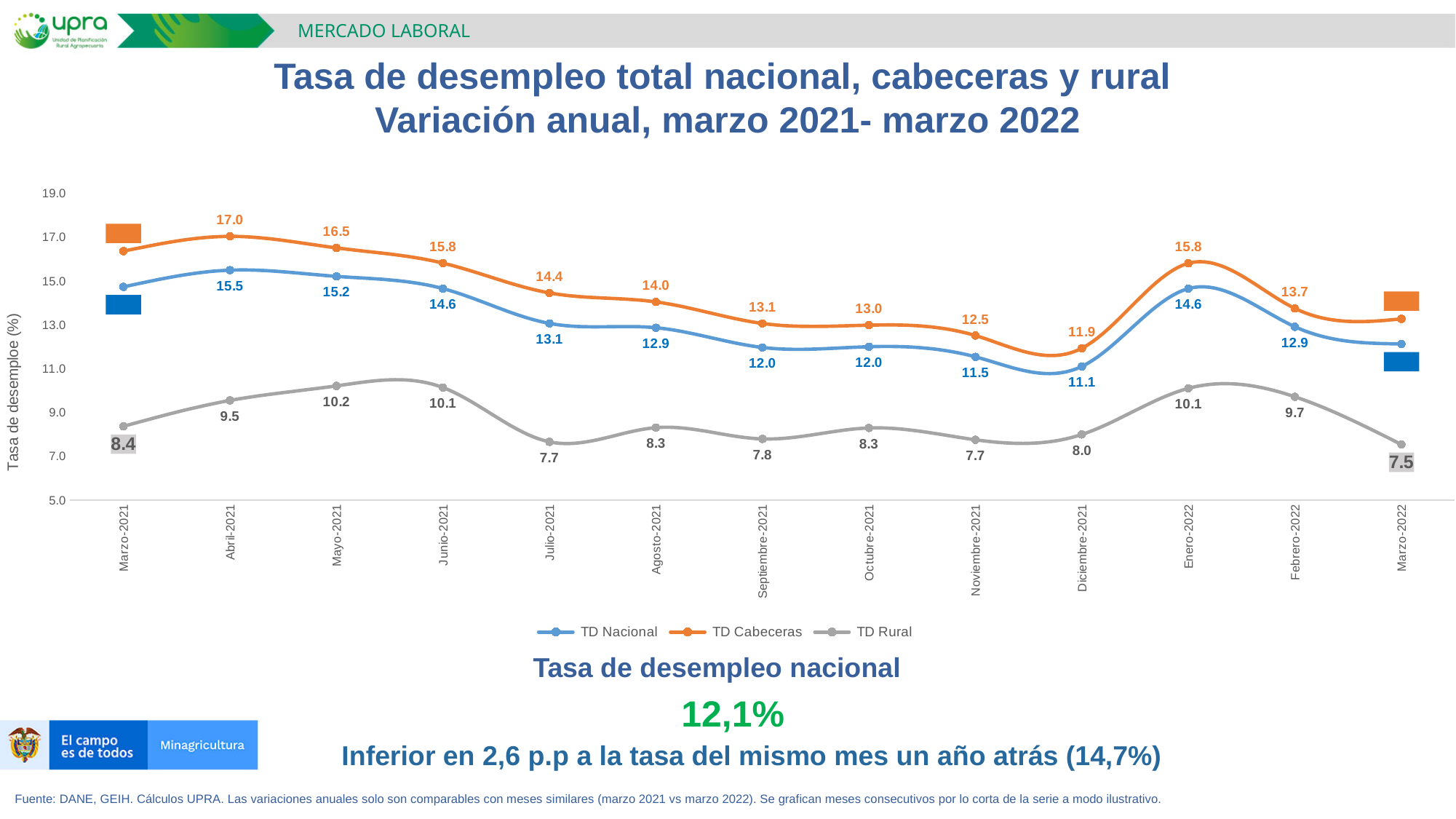
What type of chart is shown on the slide? Line chart How many months are plotted along the x axis? 13 In which month does TD Cabeceras reach its highest value? Abril-2021 Does TD Nacional rise or fall from Abril-2021 to Diciembre-2021? Fall What is the difference between TD Cabeceras and TD Nacional in Abril-2021? 1.5 Is the TD Cabeceras value for Marzo-2021 greater or less than 15.0? greater What is the TD Cabeceras value for Abril-2021? 17.0 How many series does the legend list? 3 In which month does TD Rural reach its lowest value? Marzo-2022 What is the TD Rural value for Mayo-2021? 10.2 Which is larger in Enero-2022, TD Nacional or TD Rural? TD Nacional What is the TD Nacional value for Diciembre-2021? 11.1